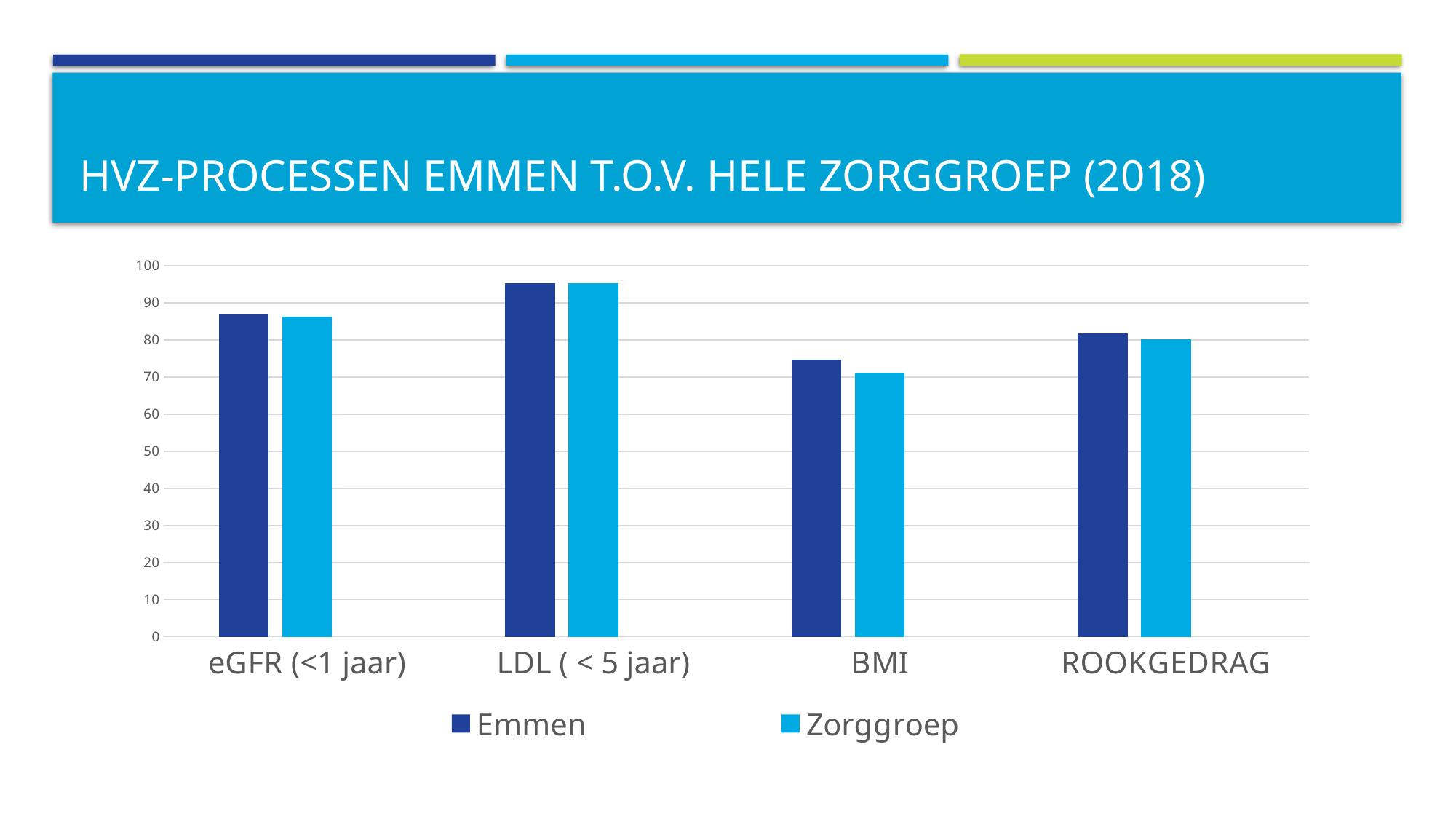
What are the two series named in the legend? Emmen and Zorggroep Is the Emmen value for eGFR (<1 jaar) greater or less than 80? greater For the Emmen series, which category has the highest value? LDL ( < 5 jaar) How many series does the legend list? 2 For BMI, which series has the larger value, Emmen or Zorggroep? Emmen Is the Zorggroep value for BMI greater or less than 80? less For the Zorggroep series, which category has the lowest value? BMI What is the title of the chart on the slide? HVZ-PROCESSEN EMMEN T.O.V. HELE ZORGGROEP (2018) How many categories are shown on the x axis of the chart? 4 For the Emmen series, which category has the lowest value? BMI Is the Emmen value for LDL ( < 5 jaar) greater or less than 90? greater What kind of chart is shown on the slide? bar chart